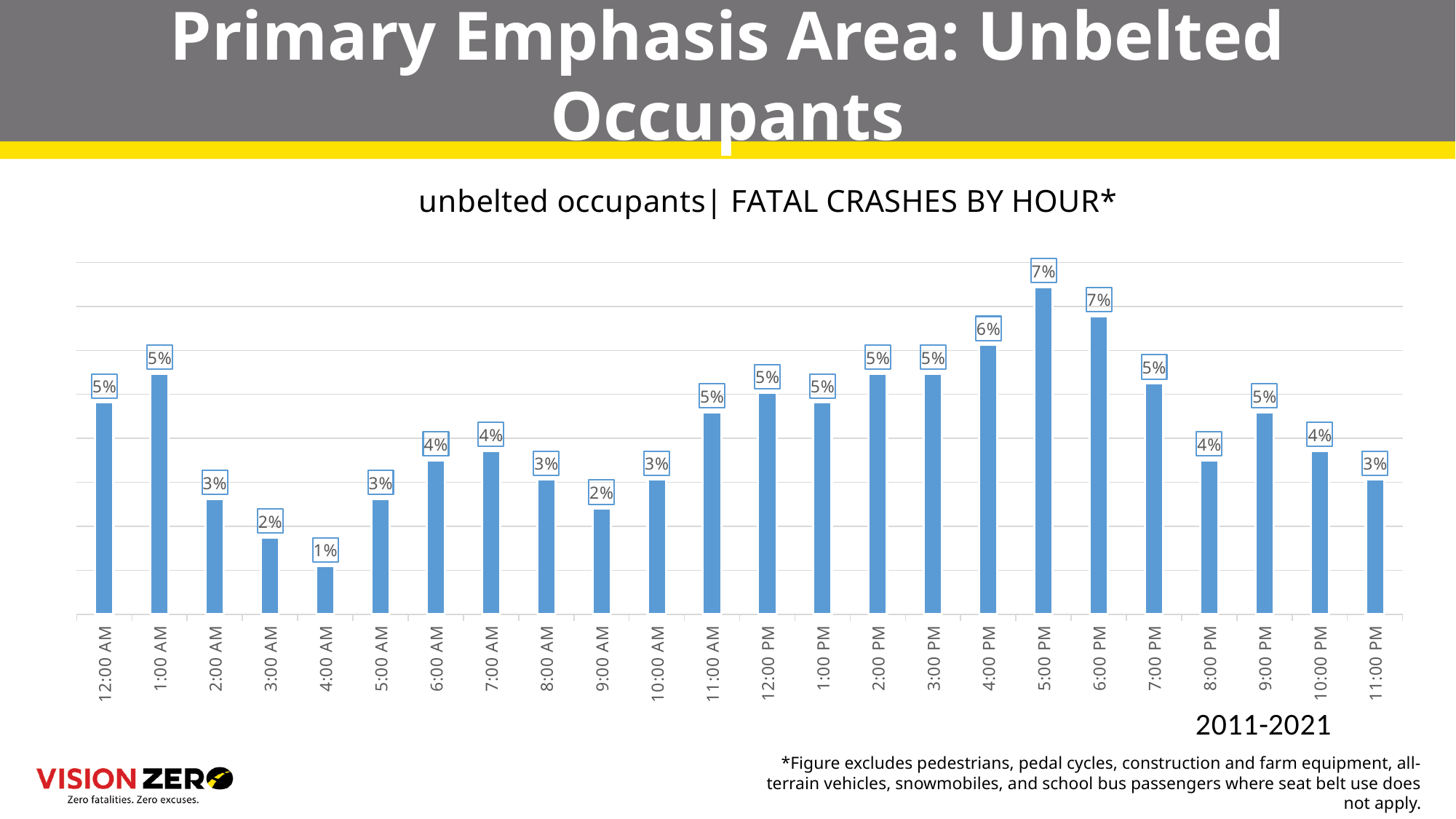
How many hourly categories are plotted on the chart? 24 What is the value for 4:00 PM? 6% Do the values rise or fall from 2:00 PM to 5:00 PM? Rise What percentage of fatal crashes involving unbelted occupants occurred at 4:00 AM? 1% Which hour has a higher value, 1:00 AM or 3:00 AM? 1:00 AM Which hour has a higher value, 9:00 AM or 11:00 AM? 11:00 AM What is the difference in percentage points between 5:00 PM and 4:00 AM? 6 percentage points Which hour has the lowest percentage of fatal crashes? 4:00 AM What percentage is shown for 11:00 PM? 3% What kind of chart is shown on the slide? Bar chart What time period does the chart cover, as noted below the chart? 2011-2021 What is the value shown for 5:00 PM? 7%